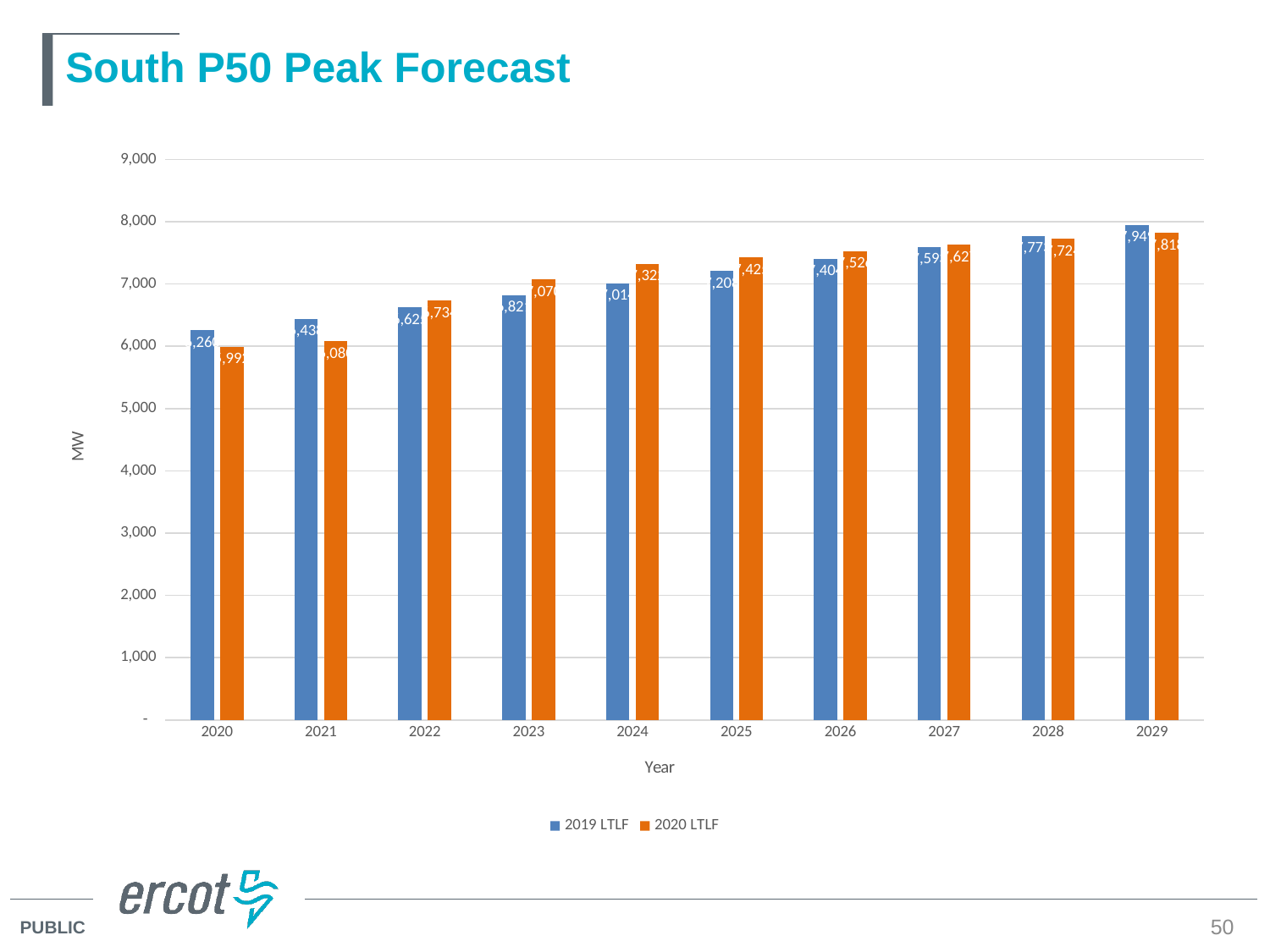
How many series does the legend list? 2 Which year has the lowest 2020 LTLF value? 2020 Is the 2019 LTLF value for 2029 greater or less than 8,000? less Is the 2019 LTLF value for 2023 greater or less than 7,000? less In 2020, which series has the larger value, 2019 LTLF or 2020 LTLF? 2019 LTLF In 2024, which series has the larger value, 2019 LTLF or 2020 LTLF? 2020 LTLF How many years are shown on the x axis? 10 What is the label on the y axis? MW Which year has the highest 2019 LTLF value? 2029 What kind of chart is shown on the slide? Bar chart Is the 2020 LTLF value for 2024 greater or less than 7,000? greater Do the 2020 LTLF values generally rise or fall from 2020 to 2029? Rise